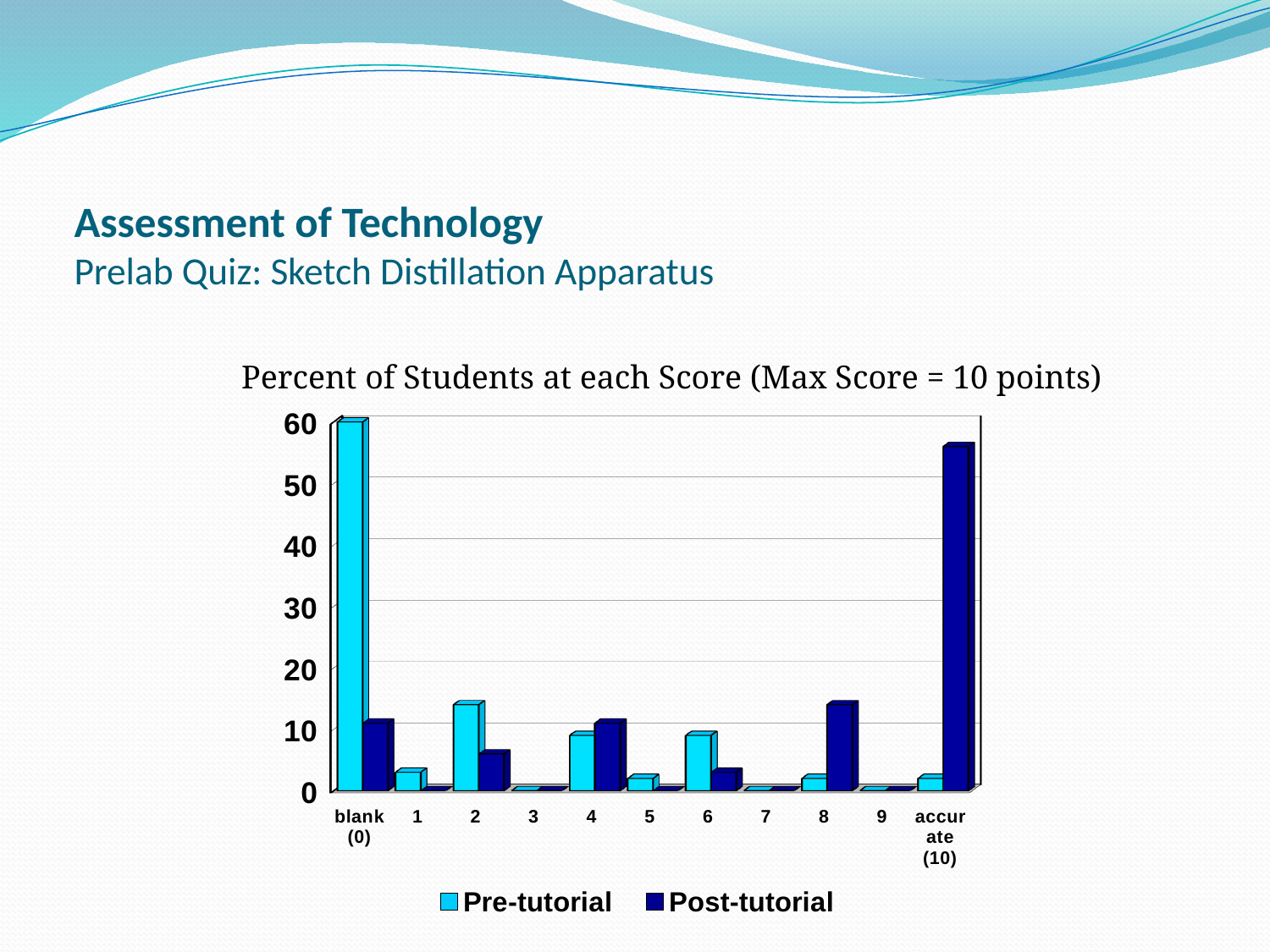
Is the Post-tutorial value for accurate (10) greater or less than 50? greater For blank (0), which series has the larger value, Pre-tutorial or Post-tutorial? Pre-tutorial Is the Post-tutorial value for blank (0) greater or less than 20? less What kind of chart is shown on the slide? bar chart For accurate (10), which series has the larger value, Pre-tutorial or Post-tutorial? Post-tutorial Is the Pre-tutorial value for score 2 greater or less than 10? greater What is the title of the chart? Percent of Students at each Score (Max Score = 10 points) How many score categories are shown on the x axis? 11 Which score category has the highest Pre-tutorial value? blank (0) Which score category has the highest Post-tutorial value? accurate (10) How many series does the legend list? 2